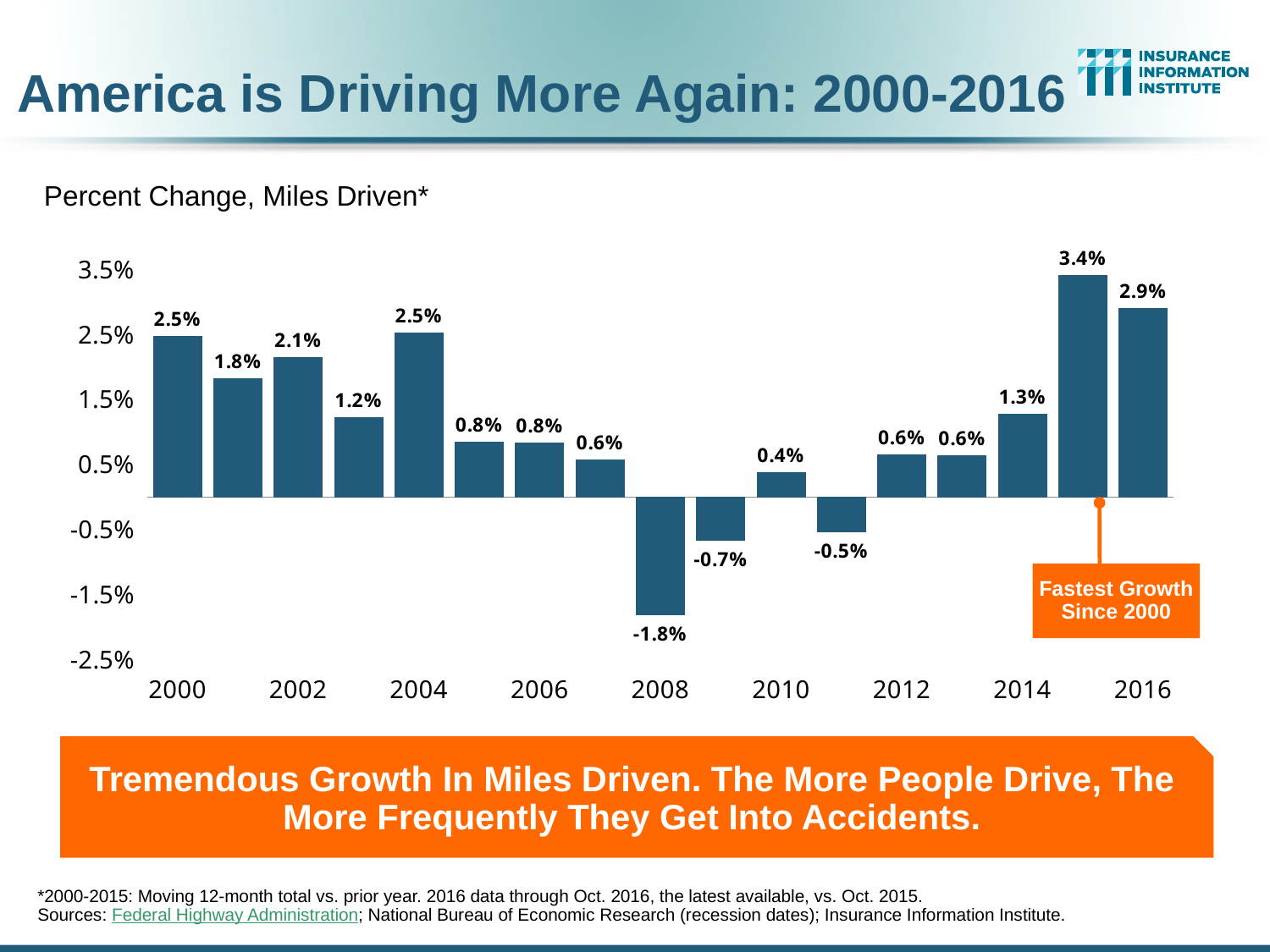
Which year has the highest percent change in miles driven? 2015 What is the percent change in miles driven for 2010? 0.4% What is the percent change in miles driven for 2016? 2.9% Which year has a larger percent change in miles driven, 2004 or 2012? 2004 What is the percent change in miles driven for 2000? 2.5% How many bars are plotted in the chart? 17 What does the orange callout box pointing at the 2015 bar say? Fastest Growth Since 2000 What is the percent change in miles driven for 2008? -1.8% Which year has the lowest percent change in miles driven? 2008 What kind of chart is shown on the slide? Bar chart What is the difference between the percent change in 2016 and in 2014? 1.6% Do the values rise or fall from 2012 to 2015? Rise